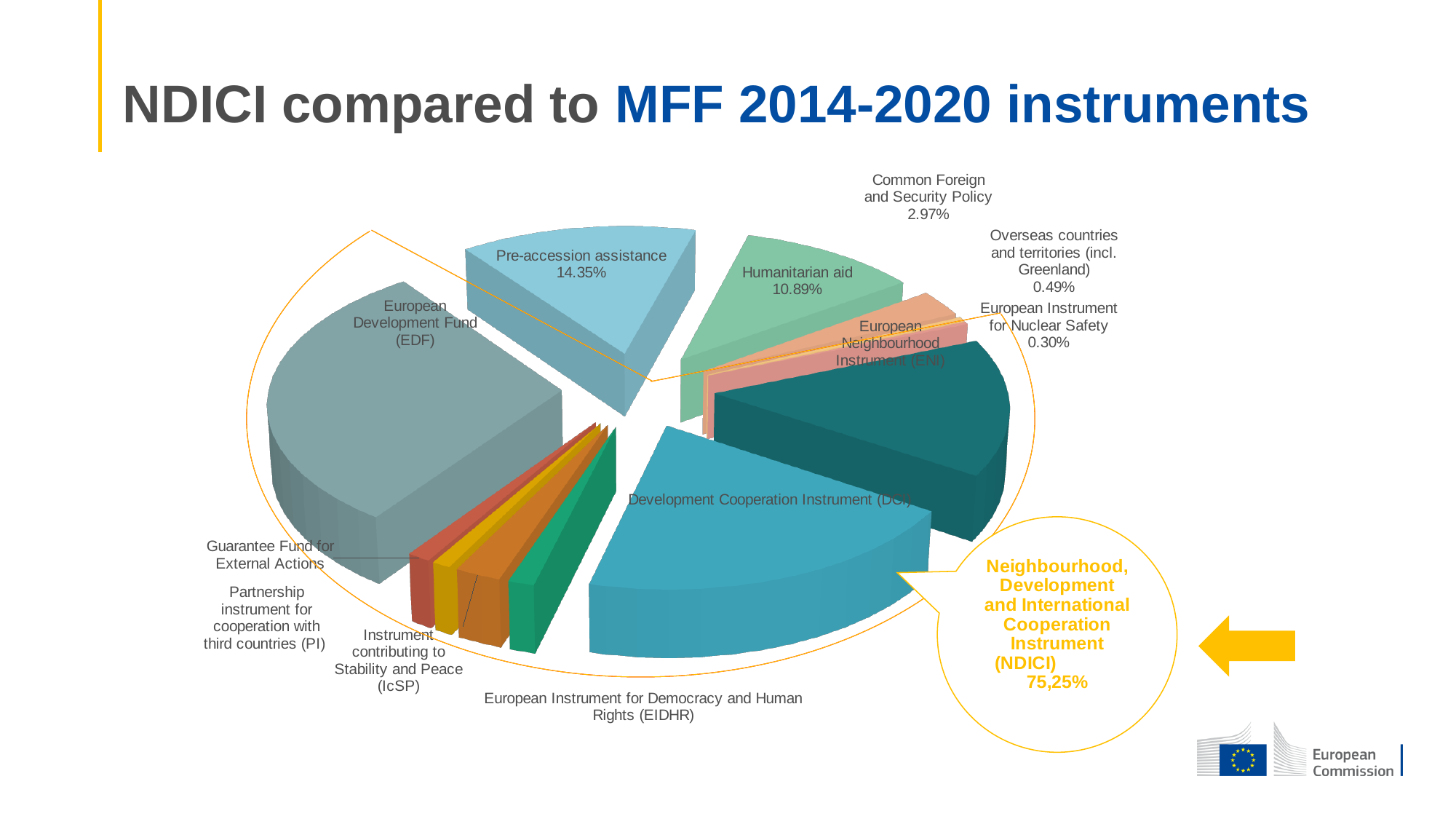
What percentage is shown for Humanitarian aid? 10.89% What kind of chart is shown on the slide? Pie chart What percentage is shown for Pre-accession assistance? 14.35% What is the title of the slide? NDICI compared to MFF 2014-2020 instruments Which has the larger share, Common Foreign and Security Policy or Overseas countries and territories (incl. Greenland)? Common Foreign and Security Policy What percentage is given in the callout for the Neighbourhood, Development and International Cooperation Instrument (NDICI)? 75,25% Which has the larger share, Pre-accession assistance or Humanitarian aid? Pre-accession assistance What percentage is shown for the European Instrument for Nuclear Safety? 0.30% Of the slices with a printed percentage, which has the smallest share? European Instrument for Nuclear Safety By how many percentage points does Pre-accession assistance exceed Humanitarian aid? 3.46 percentage points What percentage is shown for Overseas countries and territories (incl. Greenland)? 0.49% What percentage is shown for Common Foreign and Security Policy? 2.97%